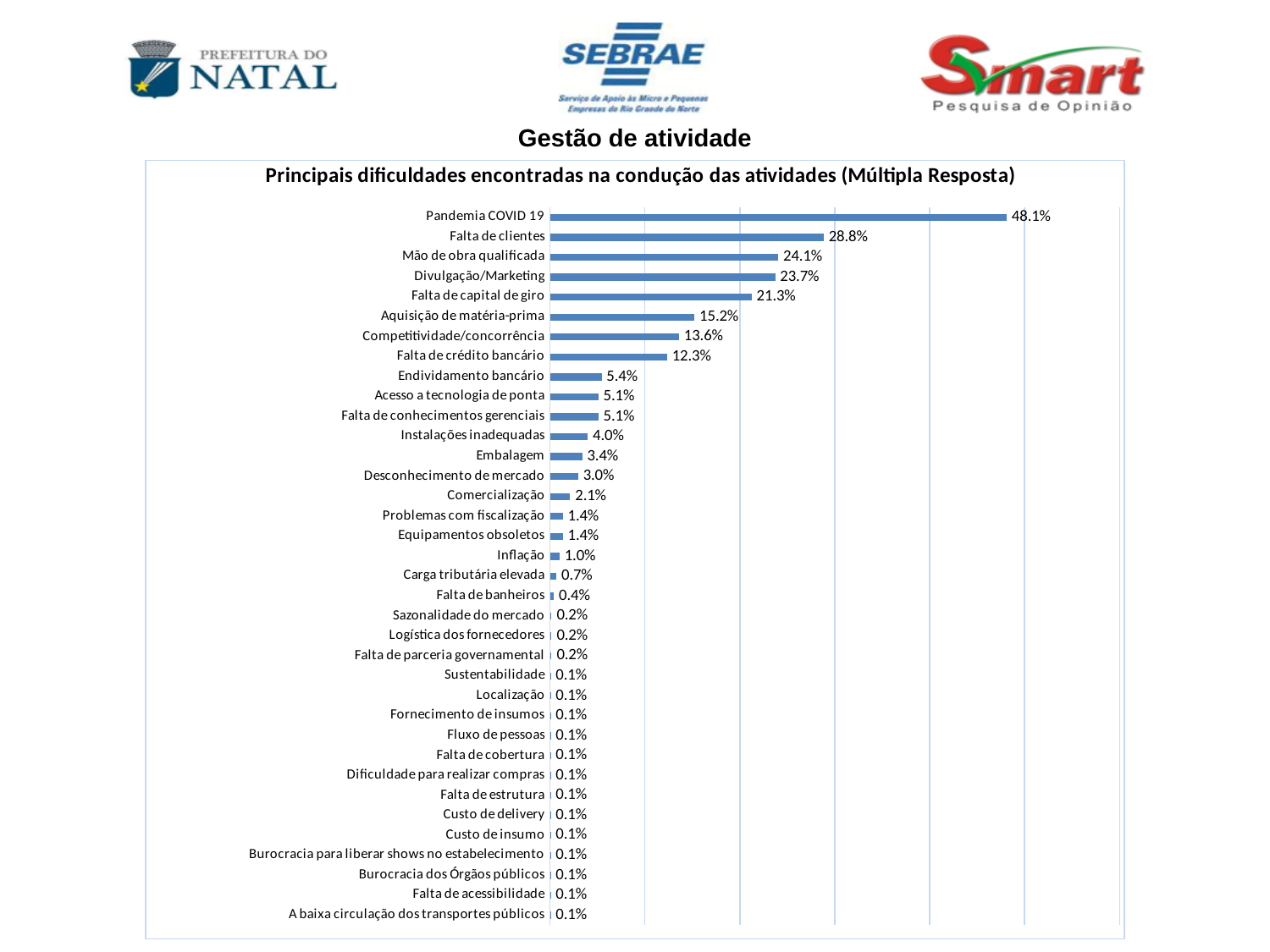
What kind of chart is shown on the slide? Bar chart How many categories are shown in the chart? 36 Which category has the highest value? Pandemia COVID 19 Which is larger, the value for Embalagem or the value for Comercialização? Embalagem What is the difference between the values for Falta de clientes and Mão de obra qualificada? 4.7% What is the value for Falta de capital de giro? 21.3% Which is larger, the value for Aquisição de matéria-prima or the value for Competitividade/concorrência? Aquisição de matéria-prima What is the value for Inflação? 1.0% What is the title of the chart? Principais dificuldades encontradas na condução das atividades (Múltipla Resposta) What is the value for Endividamento bancário? 5.4% What is the value for Pandemia COVID 19? 48.1% What is the difference between the values for Pandemia COVID 19 and Falta de clientes? 19.3%